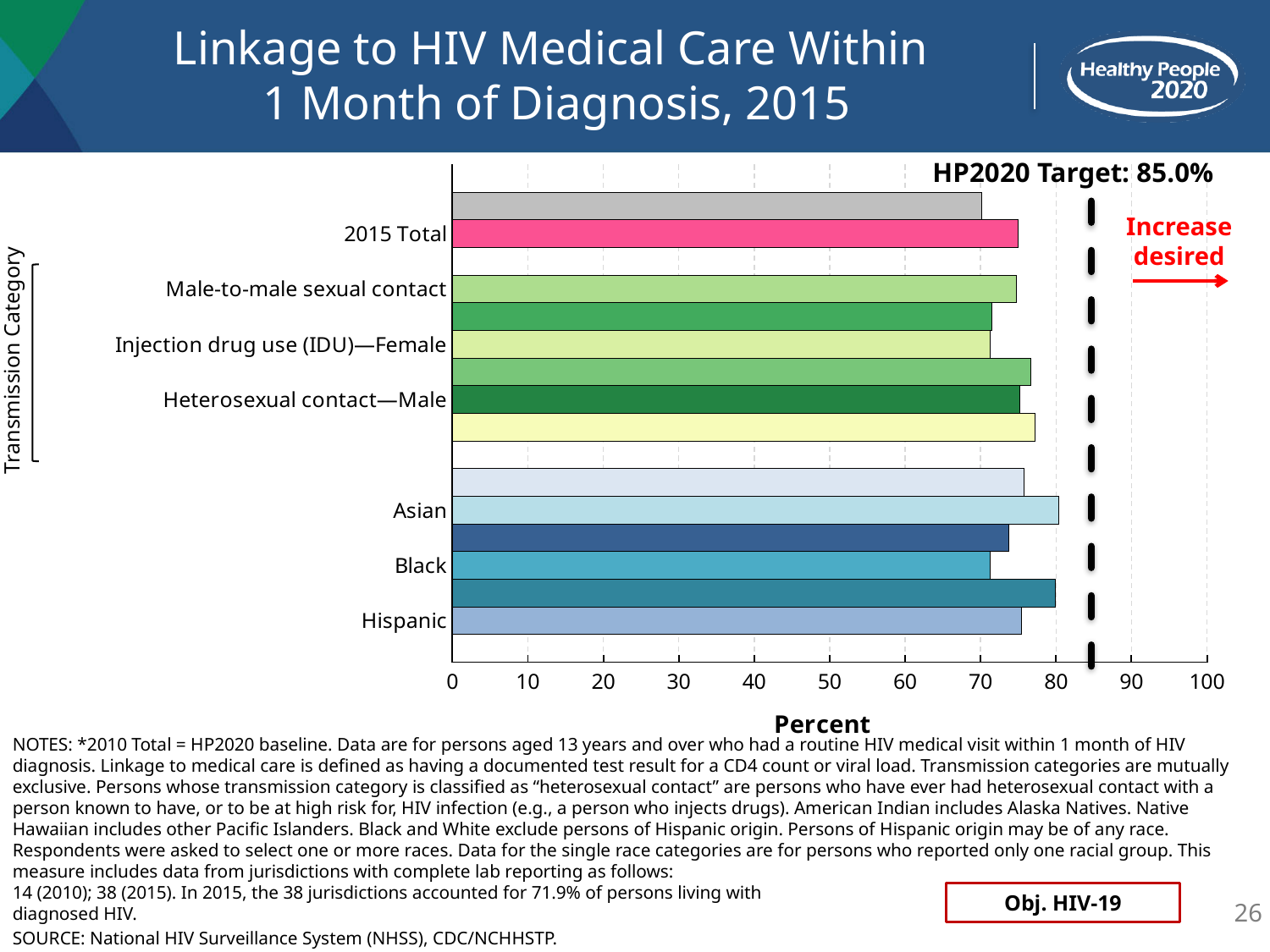
Is the value for Black greater or less than 80? less Is the value for Heterosexual contact—Male greater or less than 70? greater Is the value for Male-to-male sexual contact greater or less than 80? less What is the HP2020 Target value shown on the chart? 85.0% What is the label of the x axis? Percent Which has the larger value, Asian or Black? Asian What kind of chart is shown on the slide? Bar chart Which has the larger value, Hispanic or Black? Hispanic